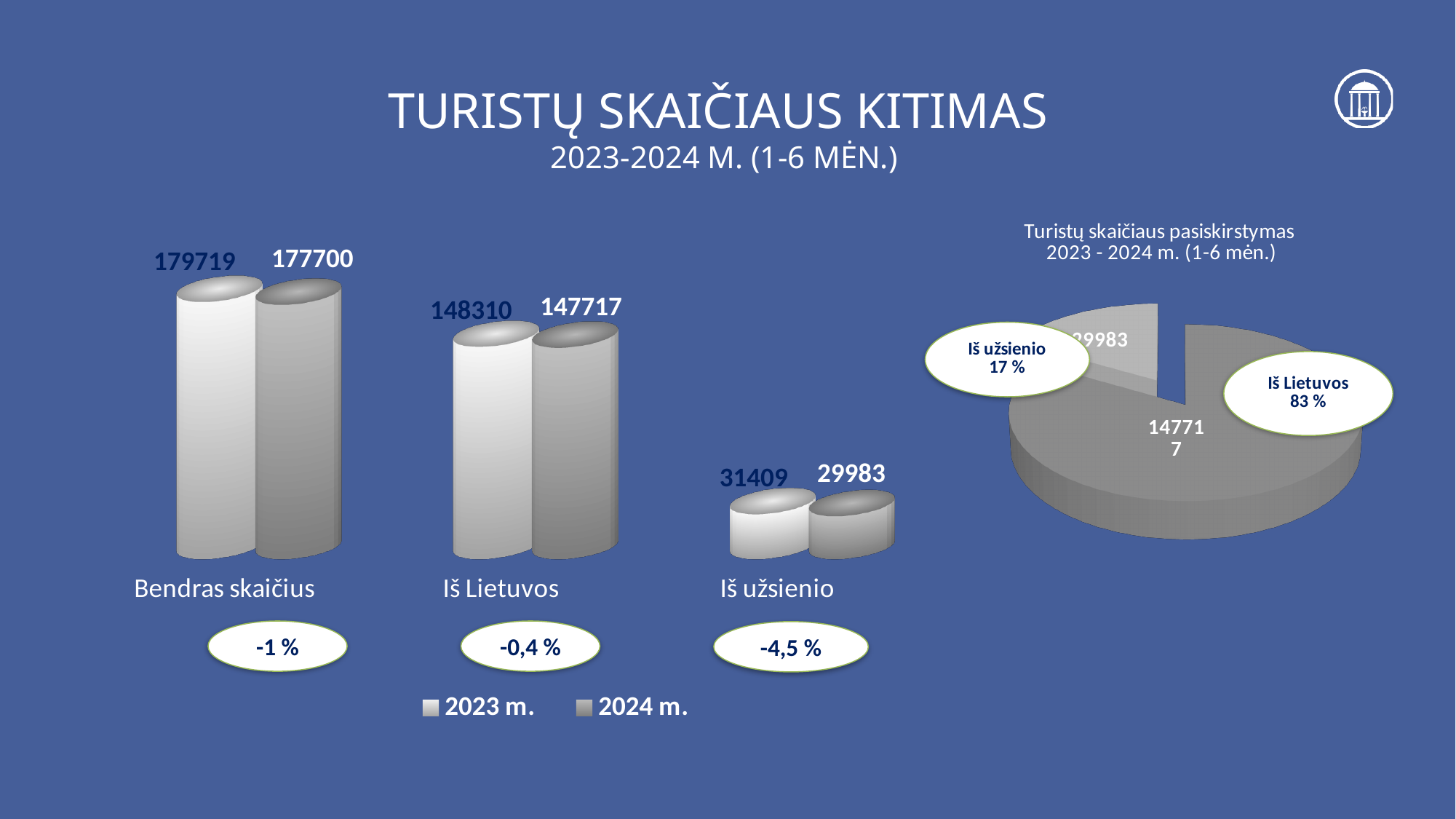
In the pie chart titled 'Turistų skaičiaus pasiskirstymas 2023 - 2024 m. (1-6 mėn.)', what share does Iš Lietuvos have? 83 % In the bar chart on the left, what is the difference between the 2023 m. and 2024 m. values for Iš užsienio? 1426 In the bar chart on the left, which is larger for Iš Lietuvos: the 2023 m. value or the 2024 m. value? 2023 m. In the bar chart on the left, which category has the highest values? Bendras skaičius What kind of chart is the chart on the left of the slide? Bar chart In the bar chart on the left, what is the value for Iš užsienio in 2024 m.? 29983 In the bar chart on the left, what is the value for Bendras skaičius in 2023 m.? 179719 In the bar chart on the left, which category has the lowest values? Iš užsienio How many series does the legend of the bar chart on the left list? 2 In the bar chart on the left, what is the value for Iš Lietuvos in 2024 m.? 147717 How many categories does the bar chart on the left show? 3 In the pie chart titled 'Turistų skaičiaus pasiskirstymas 2023 - 2024 m. (1-6 mėn.)', which slice is smaller? Iš užsienio